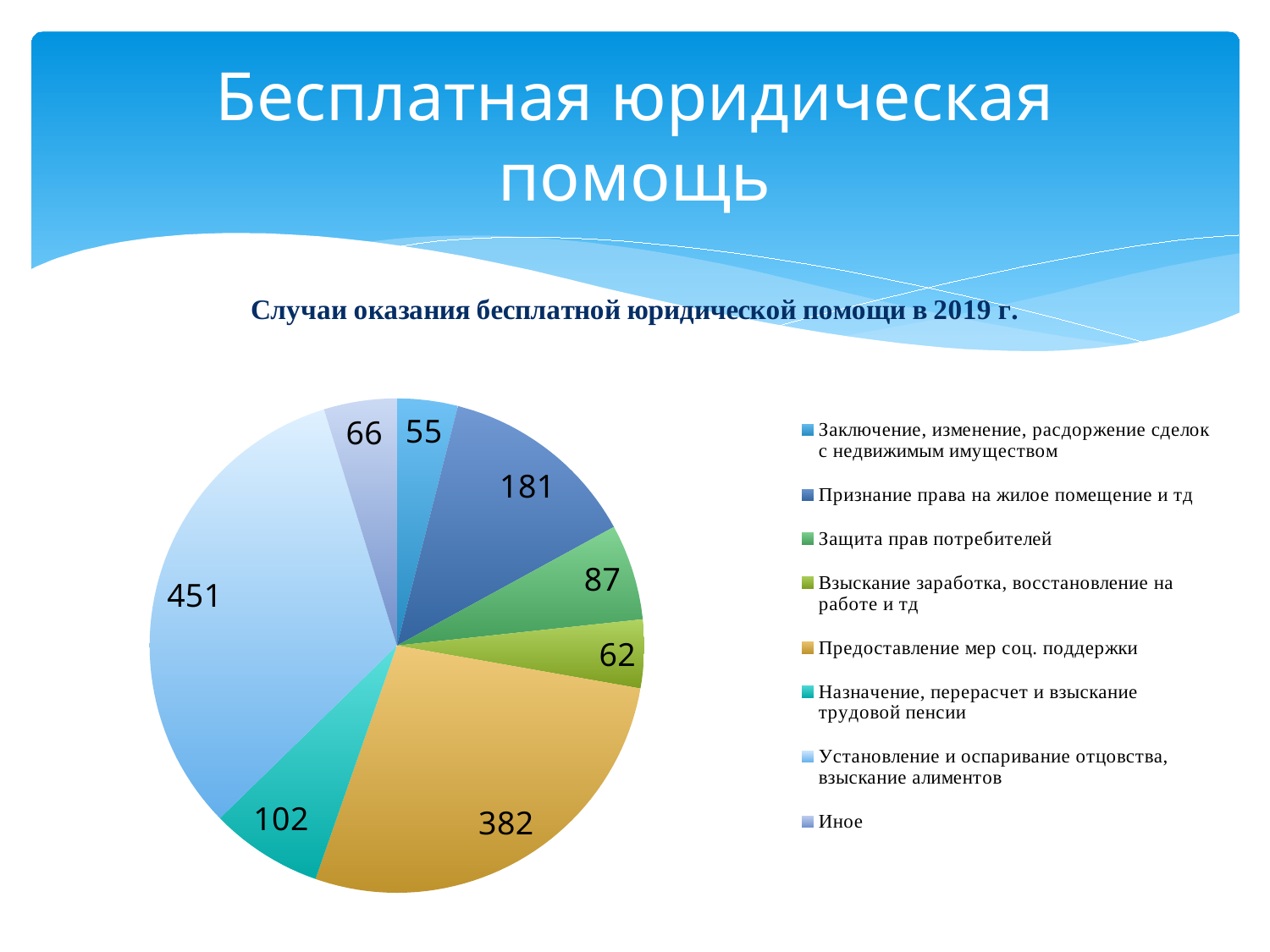
How many entries does the legend list? 8 Which is larger: the value for "Назначение, перерасчет и взыскание трудовой пенсии" or the value for "Защита прав потребителей"? Назначение, перерасчет и взыскание трудовой пенсии What is the value for "Иное"? 66 Which category has the largest slice? Установление и оспаривание отцовства, взыскание алиментов What is the title of the chart? Случаи оказания бесплатной юридической помощи в 2019 г. Which category has the smallest slice? Заключение, изменение, расдоржение сделок с недвижимым имуществом What is the difference between the values for "Установление и оспаривание отцовства, взыскание алиментов" and "Предоставление мер соц. поддержки"? 69 What is the value for "Защита прав потребителей"? 87 What is the value for "Предоставление мер соц. поддержки"? 382 How many slices does the pie chart have? 8 What kind of chart is shown on the slide? pie chart What is the value for "Признание права на жилое помещение и тд"? 181